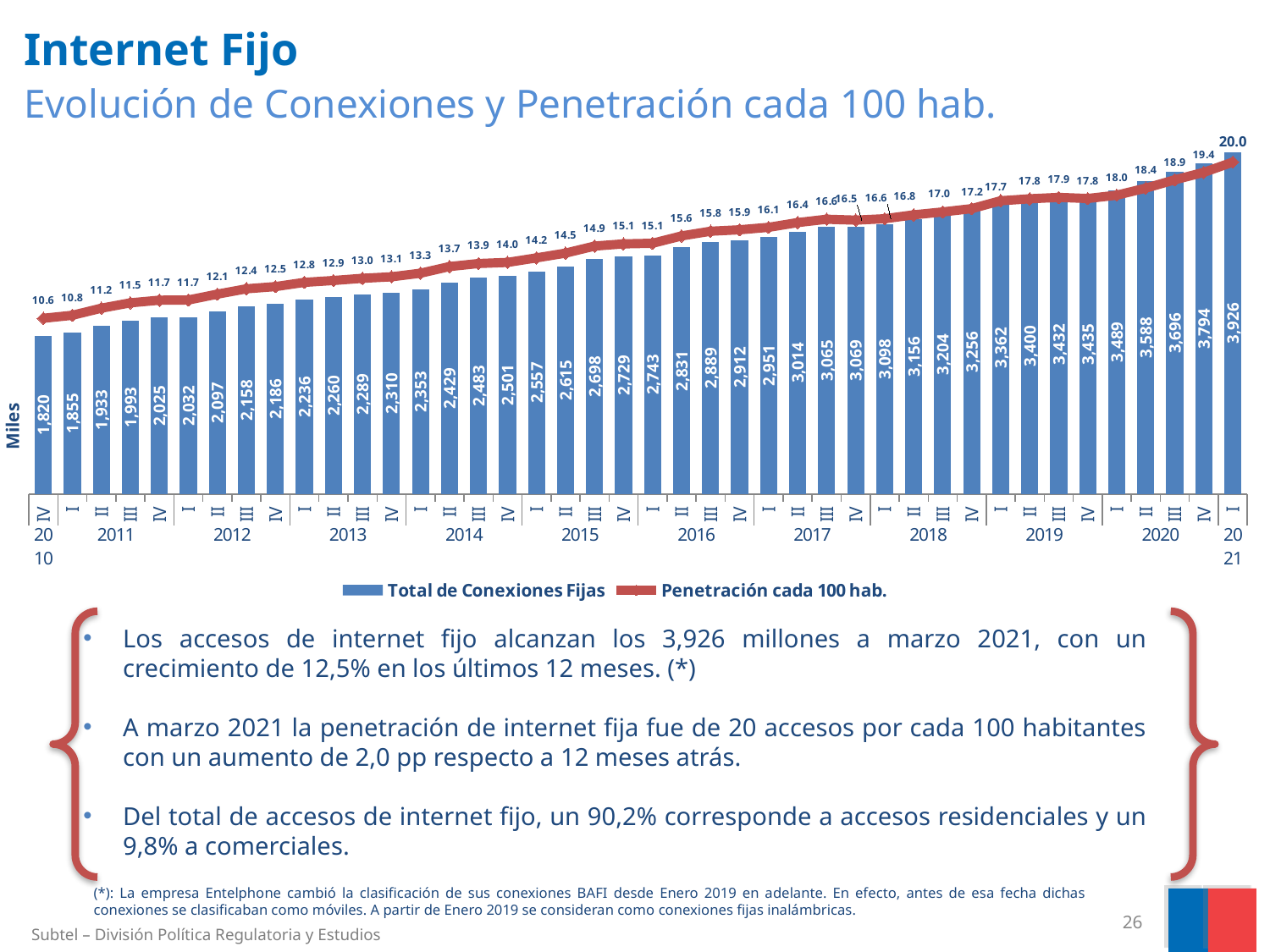
Does the Penetración cada 100 hab. line generally rise or fall from IV 2010 to I 2021? Rise What is the Penetración cada 100 hab. value for II 2018? 16.8 Which quarter has the lowest Penetración cada 100 hab.? IV 2010 What kind of chart is used for Total de Conexiones Fijas? Bar chart What is the difference in Total de Conexiones Fijas between I 2021 and I 2020? 437 What is the value of Total de Conexiones Fijas for IV 2015? 2,729 How many series does the legend list? 2 Which is larger, the Total de Conexiones Fijas for IV 2017 or for III 2017? IV 2017 What is the Penetración cada 100 hab. value for IV 2010? 10.6 Which quarter has the highest Total de Conexiones Fijas? I 2021 What is the value of Total de Conexiones Fijas for I 2021? 3,926 How many quarters are plotted on the chart? 42